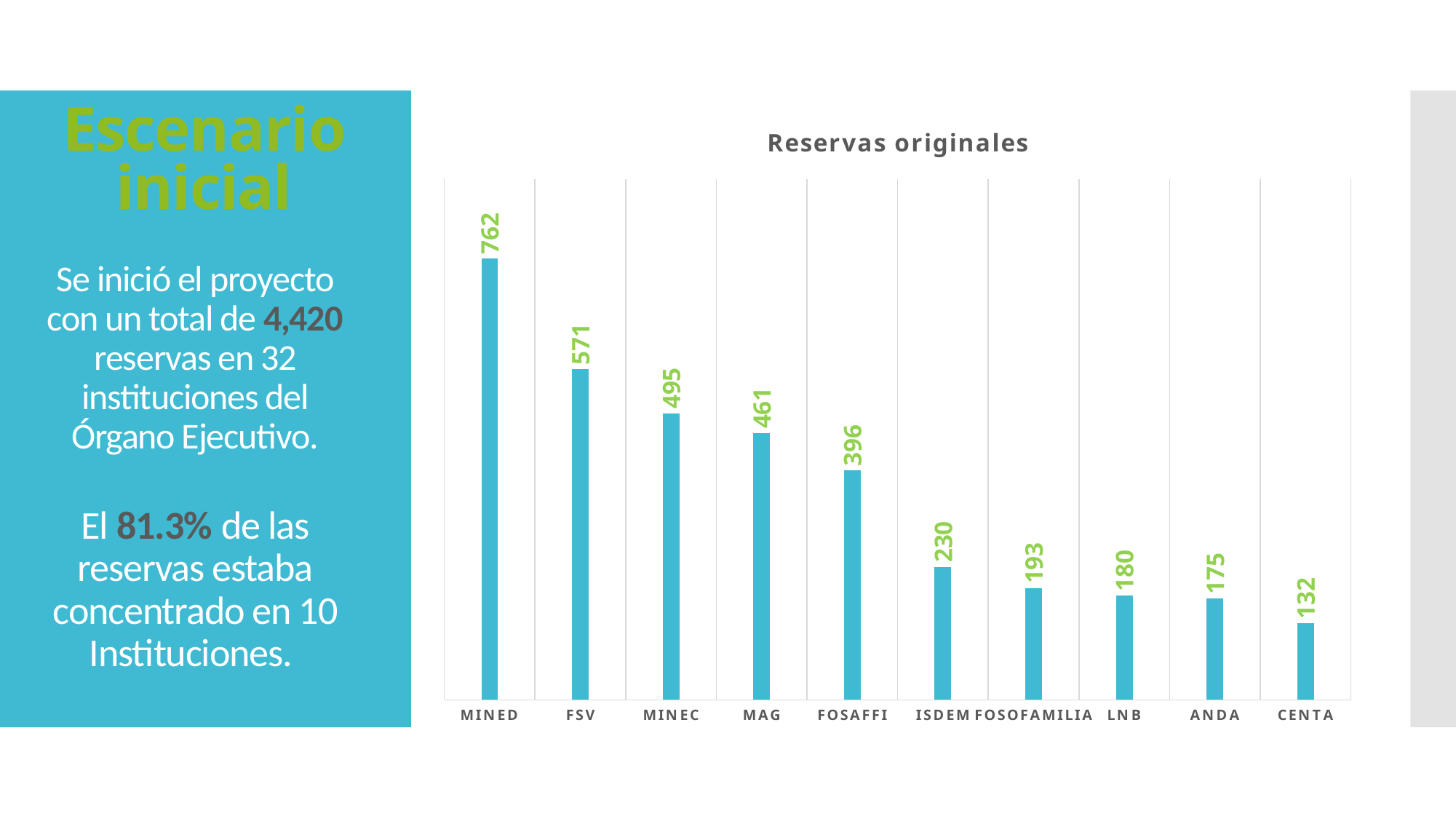
What is the difference between the values for MAG and ISDEM? 231 Which is larger, the value for MINEC or the value for FOSAFFI? MINEC What is the difference between the values for MINED and FSV? 191 What is the value for FOSAFFI in the chart? 396 Which institution has the highest value in the chart? MINED What kind of chart is shown on the slide? Bar chart Which institution has the lowest value in the chart? CENTA What is the title of the chart? Reservas originales What is the value for MINED in the chart? 762 What is the value for LNB in the chart? 180 How many institutions are shown on the x axis of the chart? 10 Do the values rise or fall from left to right along the x axis? Fall